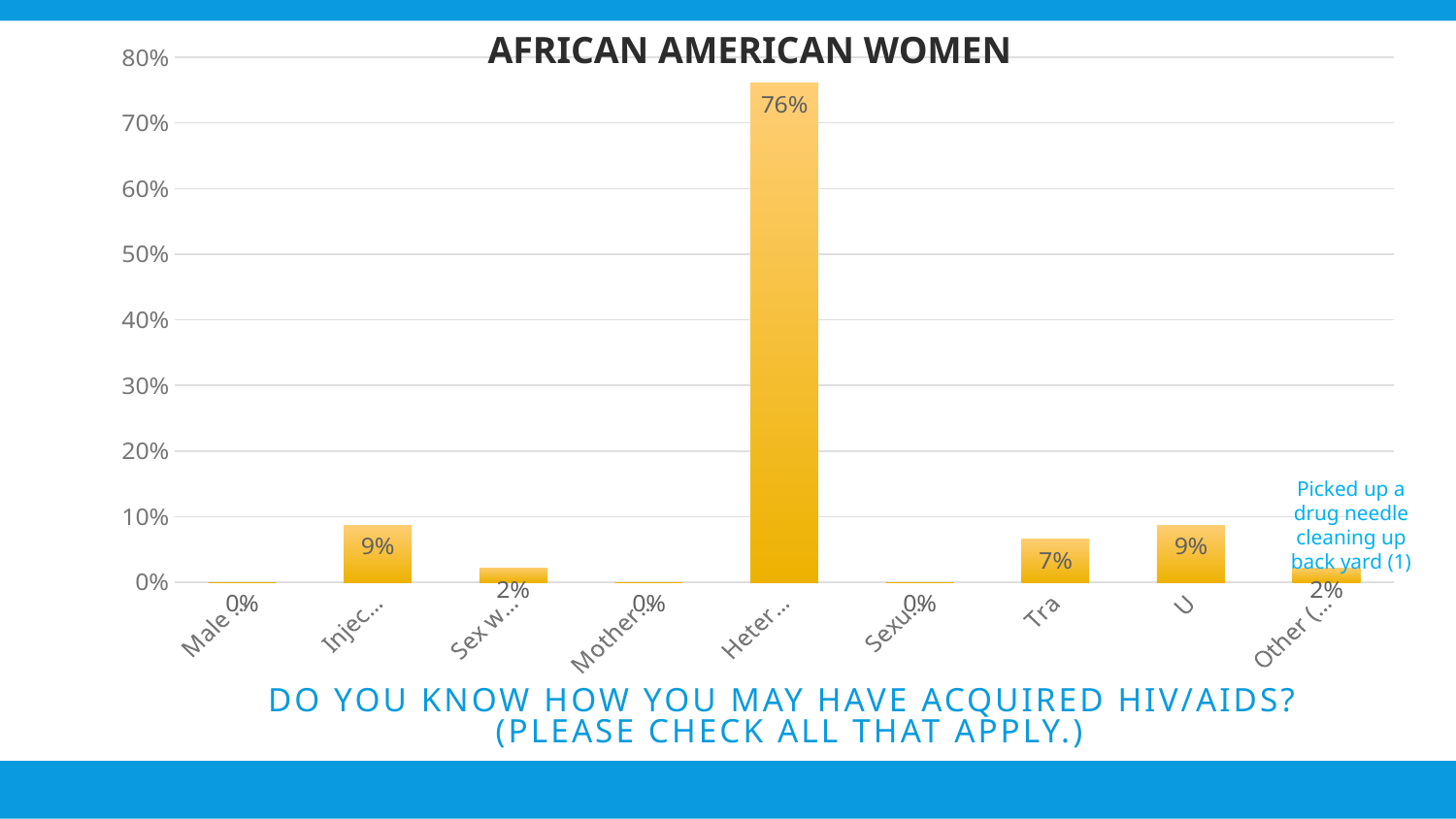
What is the value shown for the category labelled 'Sex w...'? 2% What is the value shown for the category labelled 'Tra'? 7% Is the value for 'Heter...' greater or less than 70%? greater Which category has the highest value in the chart? Heter... What is the value shown for the category labelled 'Heter...'? 76% What is the title of the chart? AFRICAN AMERICAN WOMEN Which is larger, the value for 'Injec...' or the value for 'Tra'? Injec... What is the value shown for the category labelled 'Injec...'? 9% What is the difference between the value for 'Heter...' and the value for 'Injec...'? 67 percentage points How many categories have a value of 0%? 3 How many categories are plotted on the x axis? 9 What kind of chart is shown on the slide? Bar chart